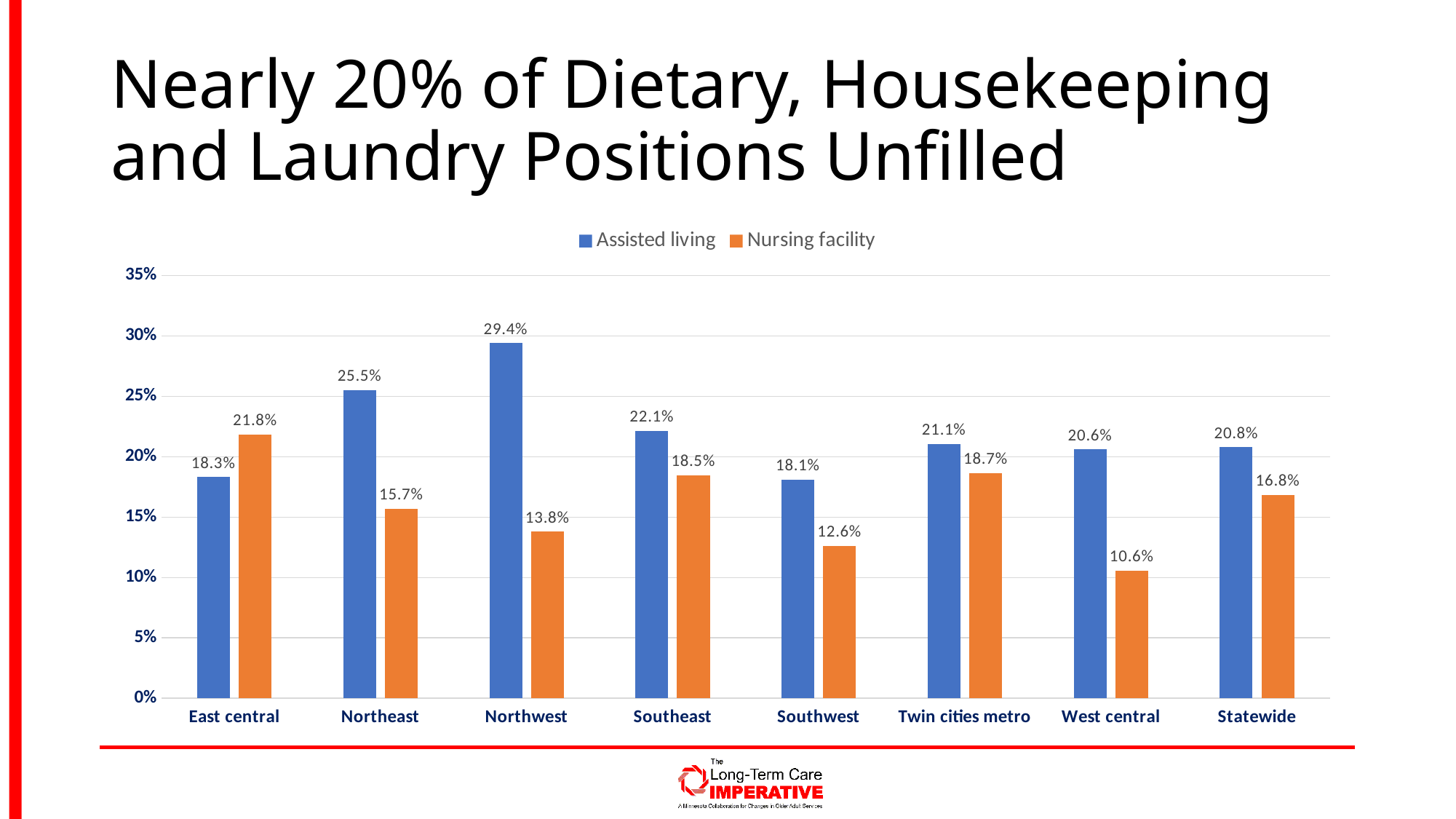
What kind of chart is shown on the slide? bar chart How many series does the legend list? 2 Which colour represents Nursing facility in the chart? orange What is the Assisted living value for Northwest? 29.4% Which region has the lowest Nursing facility value? West central Which region has the highest Assisted living value? Northwest Is the Nursing facility value for Southwest greater or less than 15%? less What is the Nursing facility value for West central? 10.6% What is the difference between the Assisted living and Nursing facility values for Northwest? 15.6% What is the Statewide value for Nursing facility? 16.8% Which is larger for East central: Assisted living or Nursing facility? Nursing facility How many categories are shown on the x axis? 8